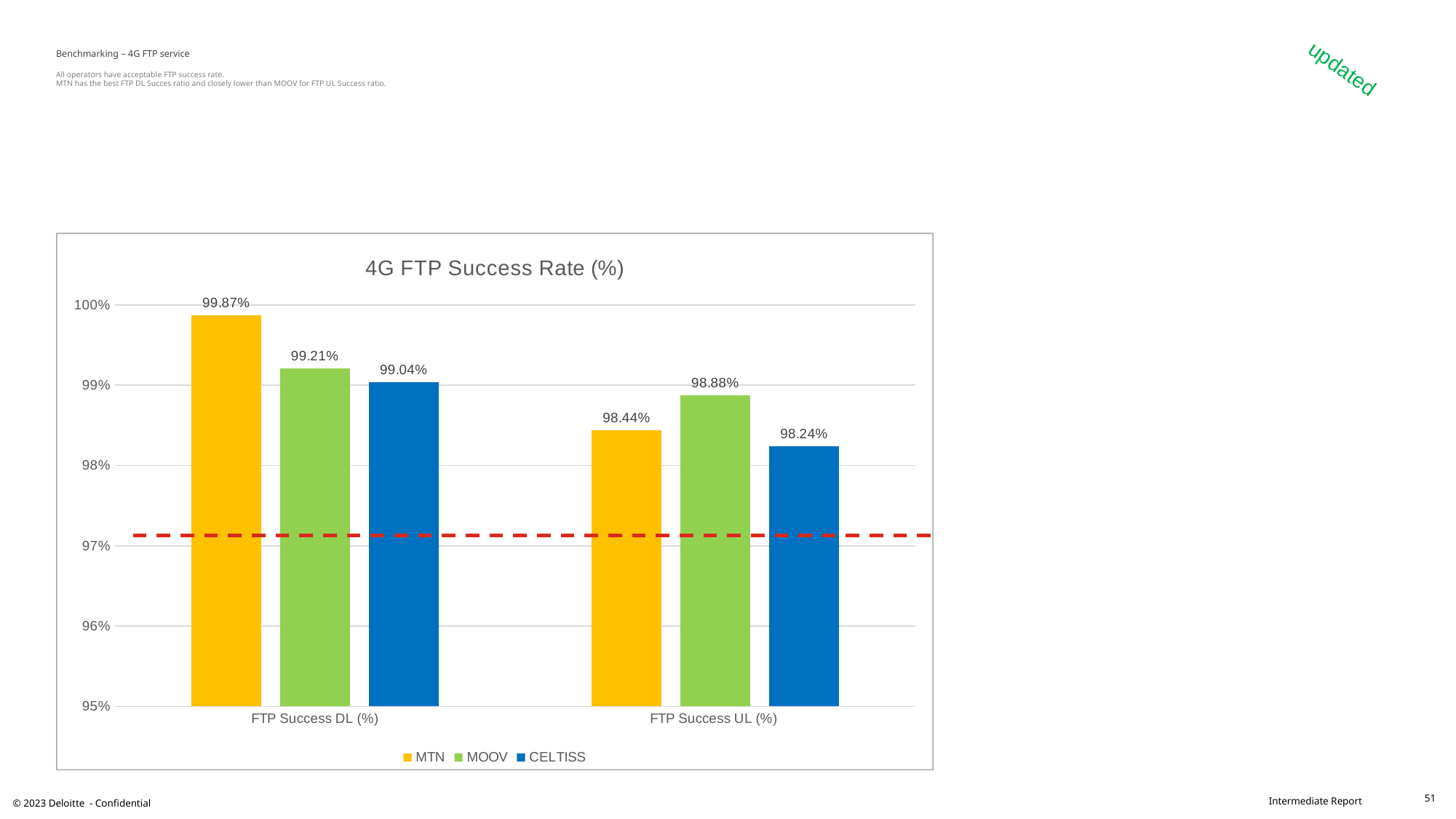
What is the FTP Success DL (%) value for MTN? 99.87% Which operator has the highest FTP Success DL (%)? MTN What is the FTP Success UL (%) value for CELTISS? 98.24% What is the FTP Success UL (%) value for MOOV? 98.88% What kind of chart is shown on the slide? Bar chart What is the difference between MTN's FTP Success DL (%) and its FTP Success UL (%)? 1.43% How many categories are shown on the x axis? 2 Is the FTP Success UL (%) value for MTN greater or less than 99%? less Which operator has the lowest FTP Success UL (%)? CELTISS Which is larger for MOOV: FTP Success DL (%) or FTP Success UL (%)? FTP Success DL (%) How many series does the legend list? 3 What is the title of the chart? 4G FTP Success Rate (%)